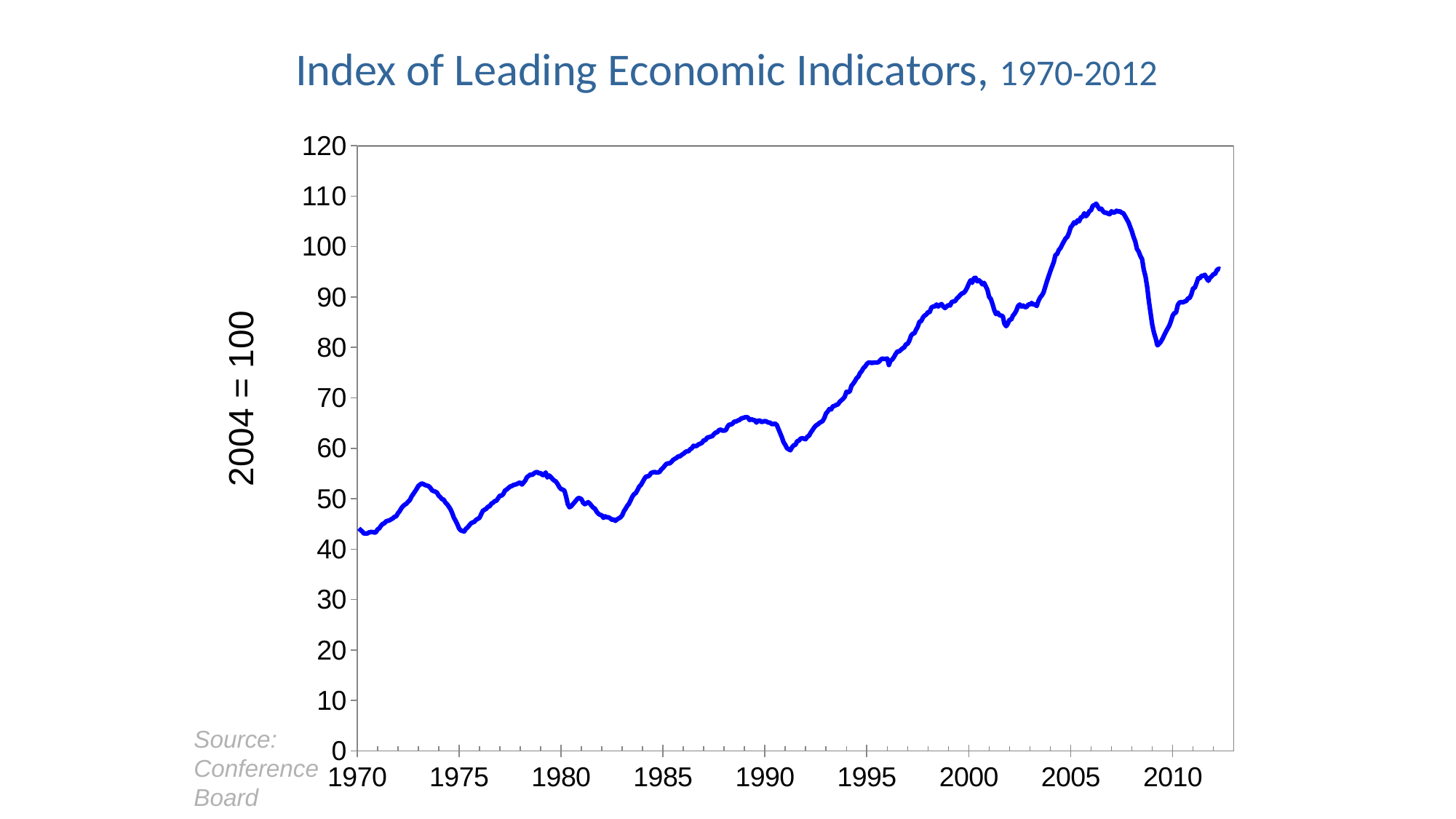
Is the value of the index in 1995 greater or less than 70? greater Is the value of the index in 2005 greater or less than 100? greater What is the title of the chart? Index of Leading Economic Indicators, 1970-2012 Is the value of the index in 1990 greater or less than 60? greater What is the label on the vertical axis of the chart? 2004 = 100 Between which two labeled years on the x axis does the index reach its highest value? 2005 and 2010 Between 2007 and 2009, does the index rise or fall? fall Does the index generally rise or fall from 1970 to 2012? rise What kind of chart is shown on the slide? line chart